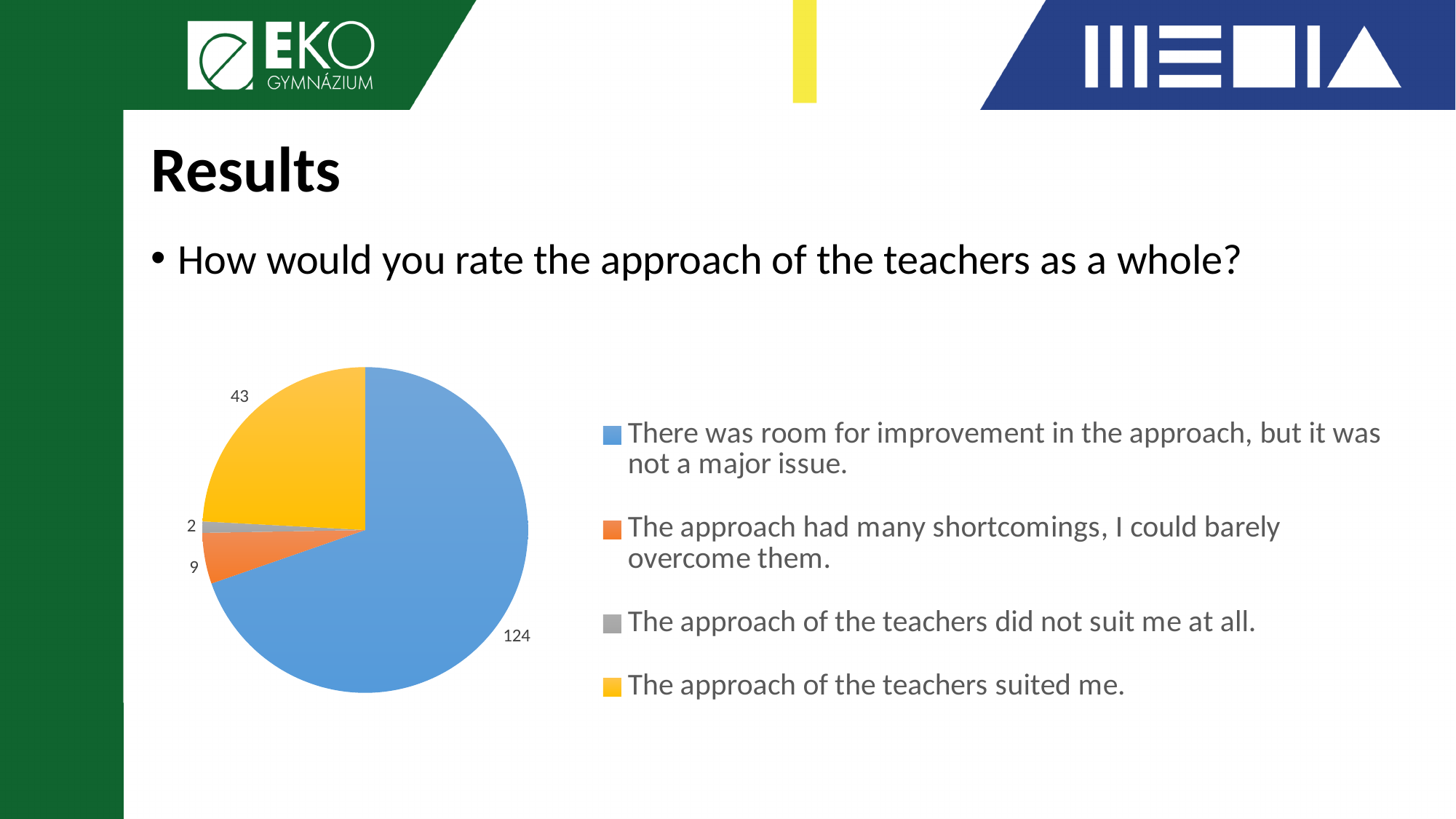
What is the value for "The approach had many shortcomings, I could barely overcome them."? 9 What kind of chart is shown on the slide? Pie chart How many entries does the legend of the pie chart list? 4 How many slices does the pie chart have? 4 What colour is the slice for "The approach of the teachers suited me."? Yellow What is the difference between the value for "There was room for improvement in the approach, but it was not a major issue." and the value for "The approach of the teachers suited me."? 81 What is the value for "There was room for improvement in the approach, but it was not a major issue."? 124 What is the value for "The approach of the teachers did not suit me at all."? 2 Which response has the largest slice of the pie chart? There was room for improvement in the approach, but it was not a major issue. What is the value for "The approach of the teachers suited me."? 43 Which is larger: the value for "The approach had many shortcomings, I could barely overcome them." or the value for "The approach of the teachers suited me."? The approach of the teachers suited me. Which response has the smallest slice of the pie chart? The approach of the teachers did not suit me at all.